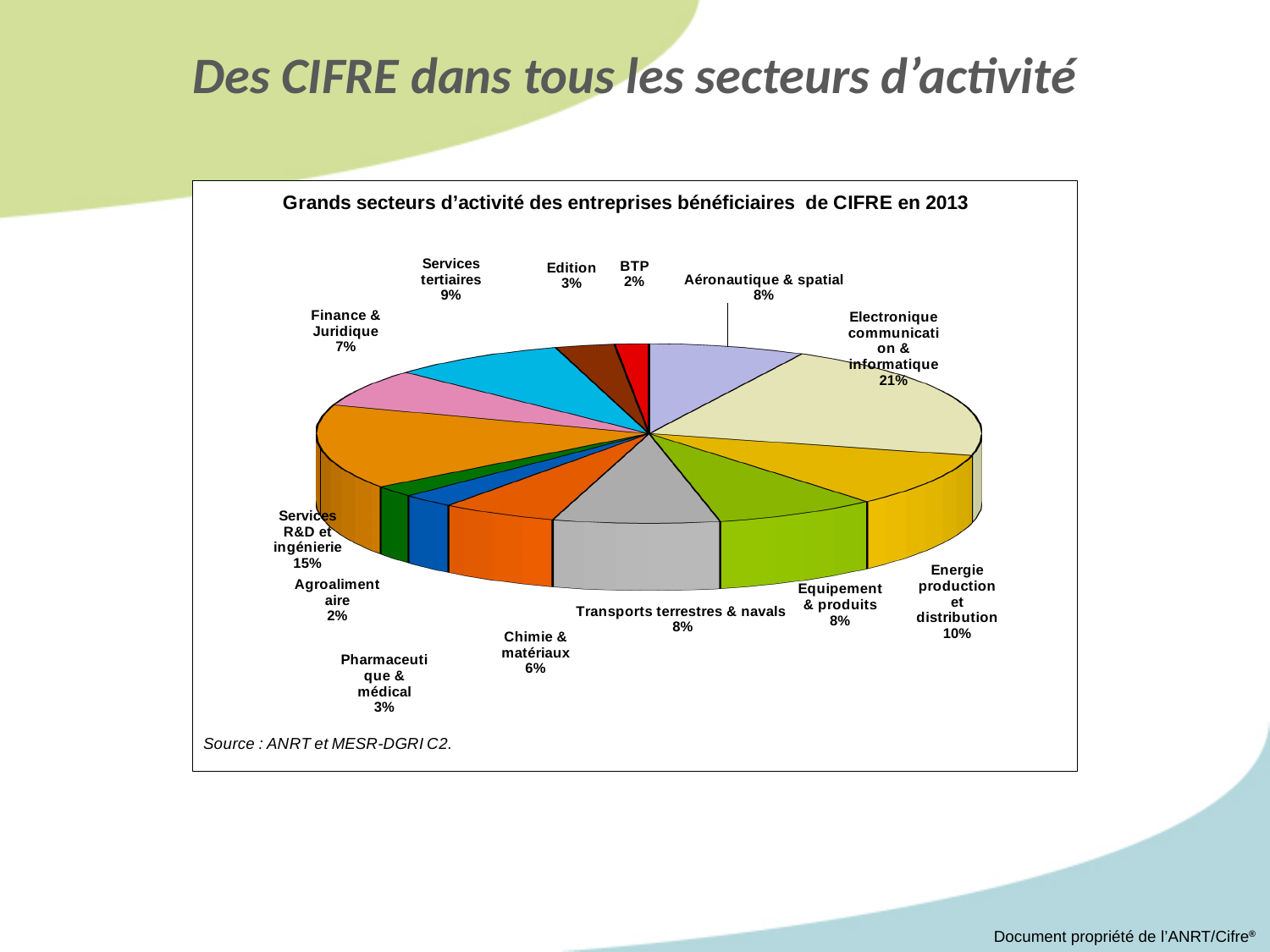
What type of chart is shown on the slide? Pie chart What share of the pie does Electronique communication & informatique represent? 21% How many sectors (slices) are shown in the pie chart? 13 What is the value shown for Energie production et distribution? 10% What source is cited below the chart? ANRT et MESR-DGRI C2 What is the value shown for Chimie & matériaux? 6% What is the value shown for Finance & Juridique? 7% What is the value shown for Services R&D et ingénierie? 15% Which has a larger share, Services tertiaires or Aéronautique & spatial? Services tertiaires Which sector has the largest share of the pie? Electronique communication & informatique What is the difference between the shares of Electronique communication & informatique and Services R&D et ingénierie? 6% What is the title of the chart? Grands secteurs d'activité des entreprises bénéficiaires de CIFRE en 2013